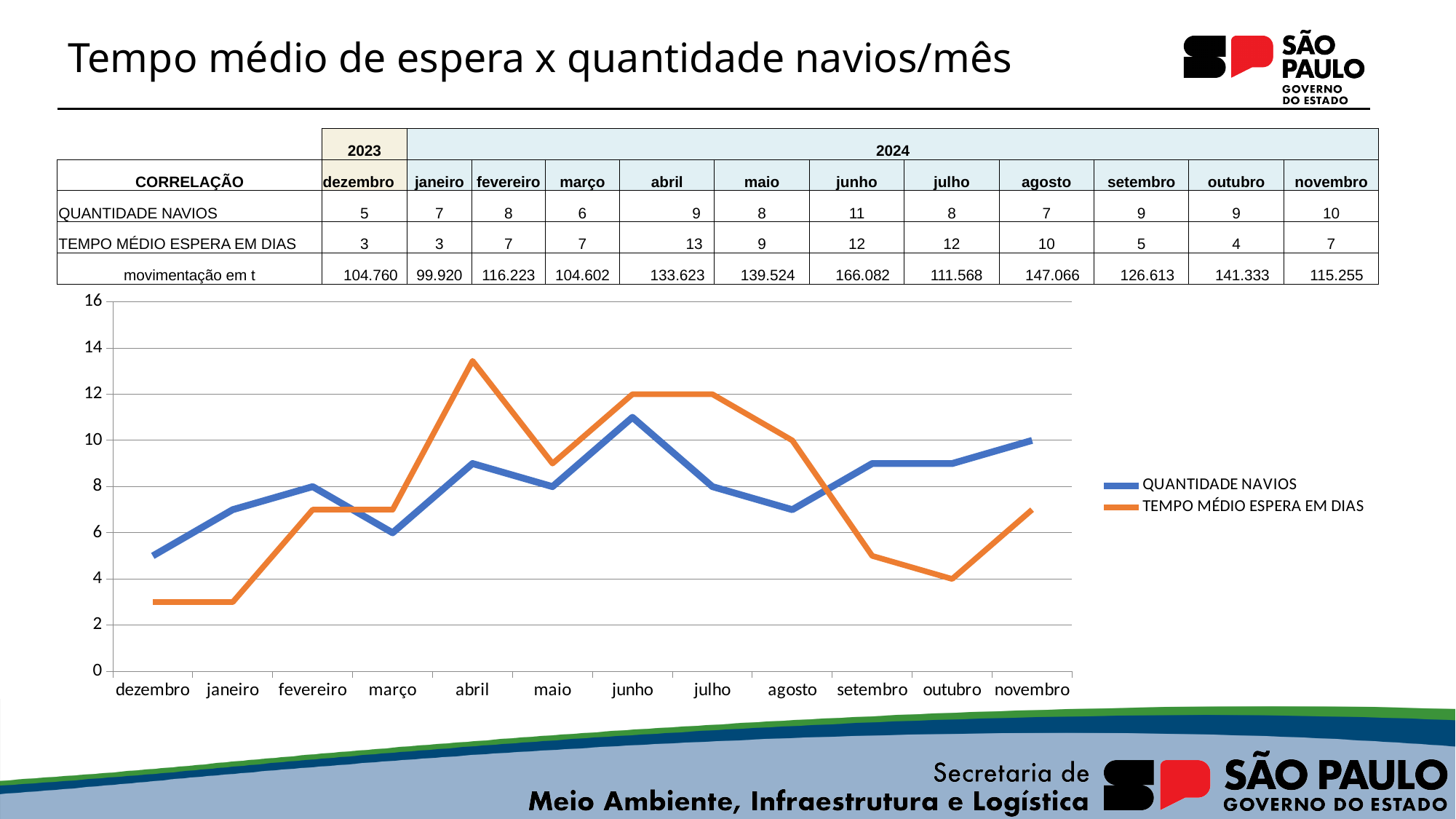
How many months are plotted along the x axis of the chart? 12 Does QUANTIDADE NAVIOS rise or fall from agosto to novembro? rise What is the value of QUANTIDADE NAVIOS for junho? 11 What kind of chart is shown on the slide? line chart In which month is QUANTIDADE NAVIOS at its lowest? dezembro Is the value of TEMPO MÉDIO ESPERA EM DIAS for outubro greater or less than 6? less How many series does the chart legend list? 2 Which colour is used for the TEMPO MÉDIO ESPERA EM DIAS line? orange In setembro, which series has the larger value, QUANTIDADE NAVIOS or TEMPO MÉDIO ESPERA EM DIAS? QUANTIDADE NAVIOS In which month does TEMPO MÉDIO ESPERA EM DIAS reach its highest value? abril What is the value of TEMPO MÉDIO ESPERA EM DIAS for abril? 13 What is the difference between TEMPO MÉDIO ESPERA EM DIAS and QUANTIDADE NAVIOS in abril? 4